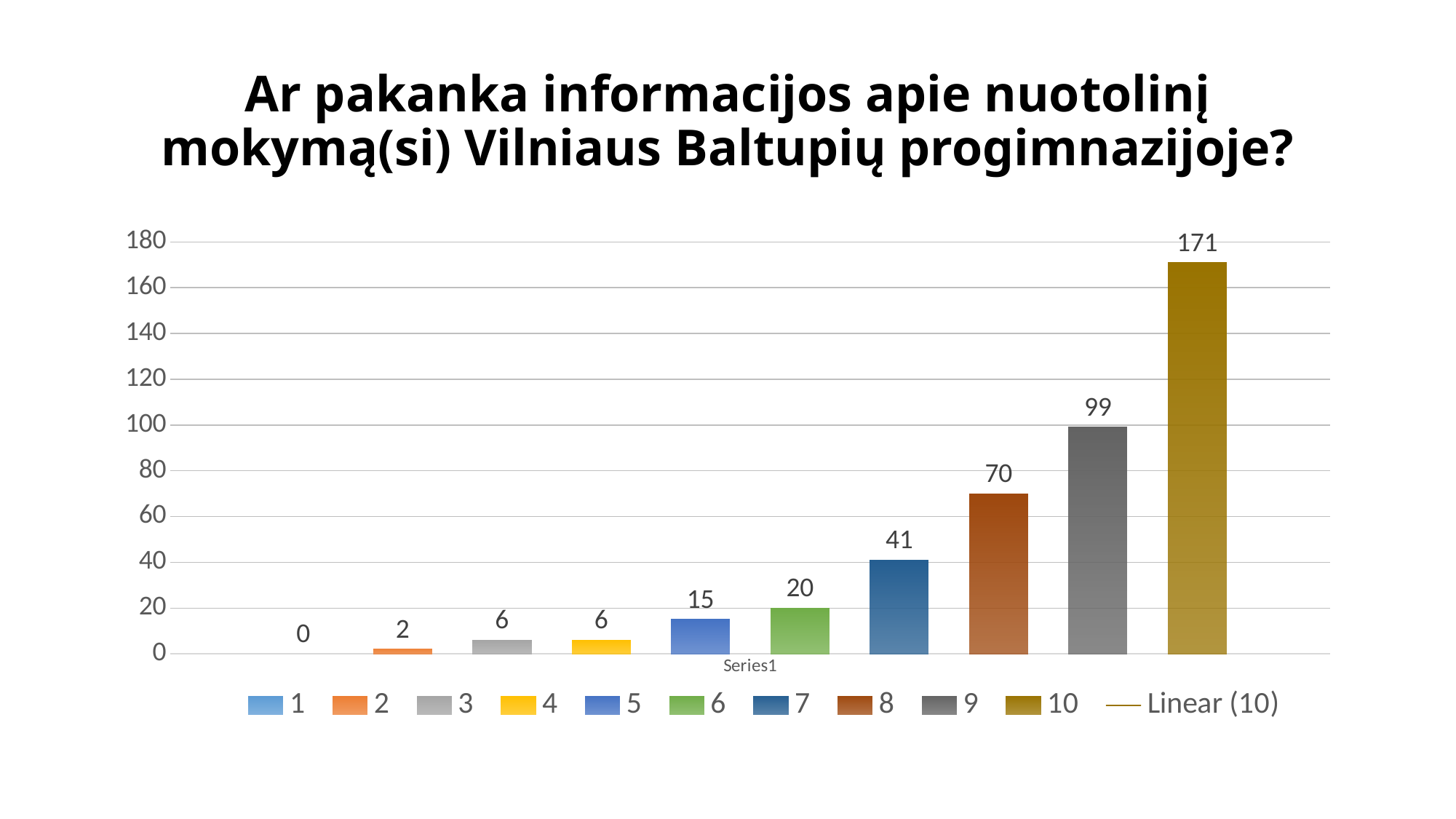
Is the value for series 9 greater or less than 80? greater What is the value for series 7? 41 What is the value for series 5? 15 Which is larger, the value for series 8 or the value for series 9? 9 What is the difference between the values for series 8 and series 6? 50 What kind of chart is shown on the slide? bar chart What is the value for series 10? 171 How many numbered series does the legend list, excluding the trendline? 10 Do the values rise or fall from series 1 to series 10? rise What is the difference between the values for series 10 and series 9? 72 Which series has the highest value? 10 Which series has the lowest value? 1